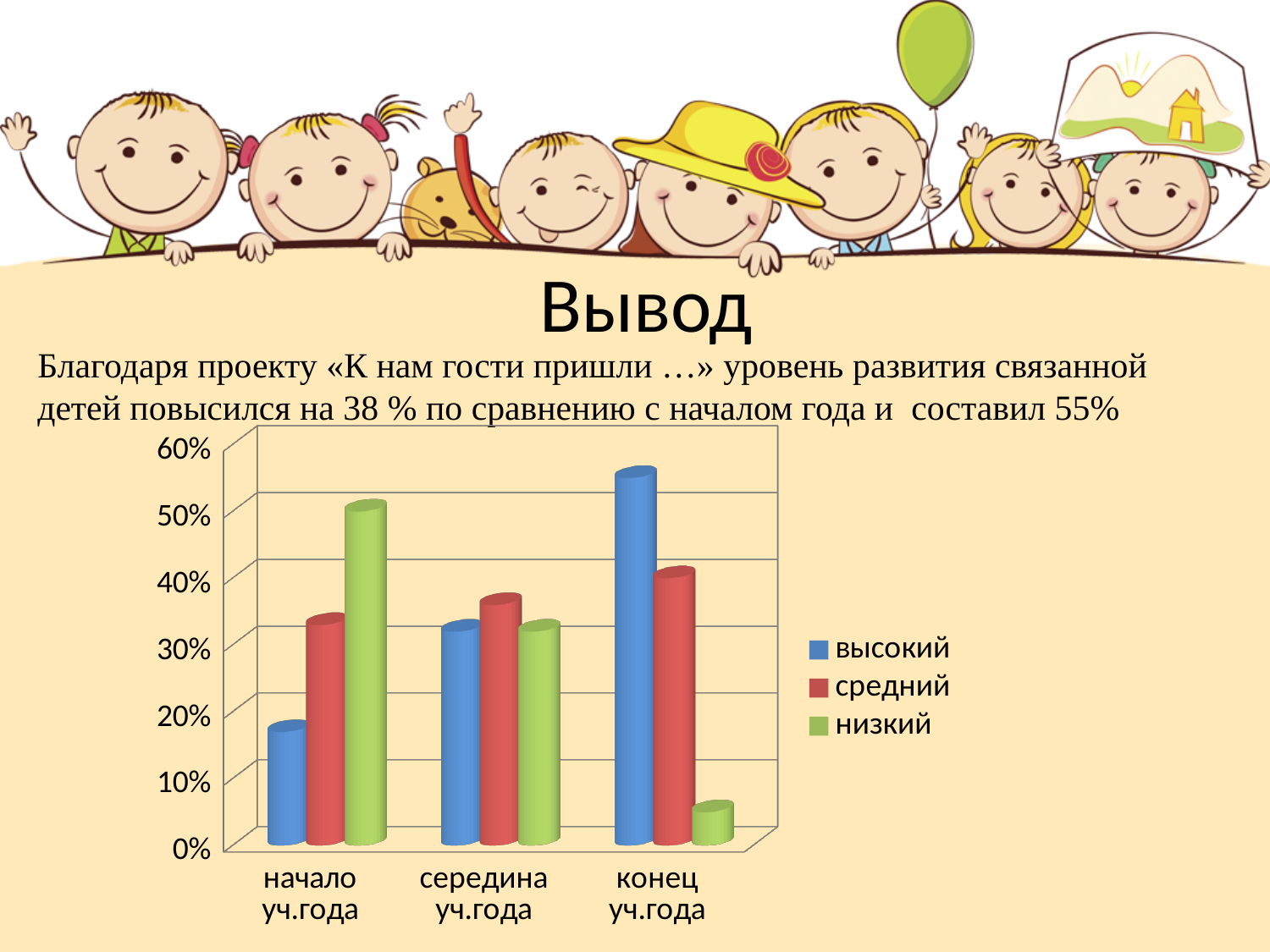
What kind of chart is shown on the slide? bar chart How many categories are shown on the x axis of the chart? 3 Which series has the highest value at начало уч.года? низкий Is the value for средний at начало уч.года greater or less than 30%? greater Does the value for высокий rise or fall from начало уч.года to конец уч.года? rise Is the value for высокий at начало уч.года greater or less than 20%? less Is the value for высокий at конец уч.года greater or less than 50%? greater How many series does the chart legend list? 3 Which series has the highest value at конец уч.года? высокий Which series has the lowest value at конец уч.года? низкий Which colour represents the series высокий in the legend? blue